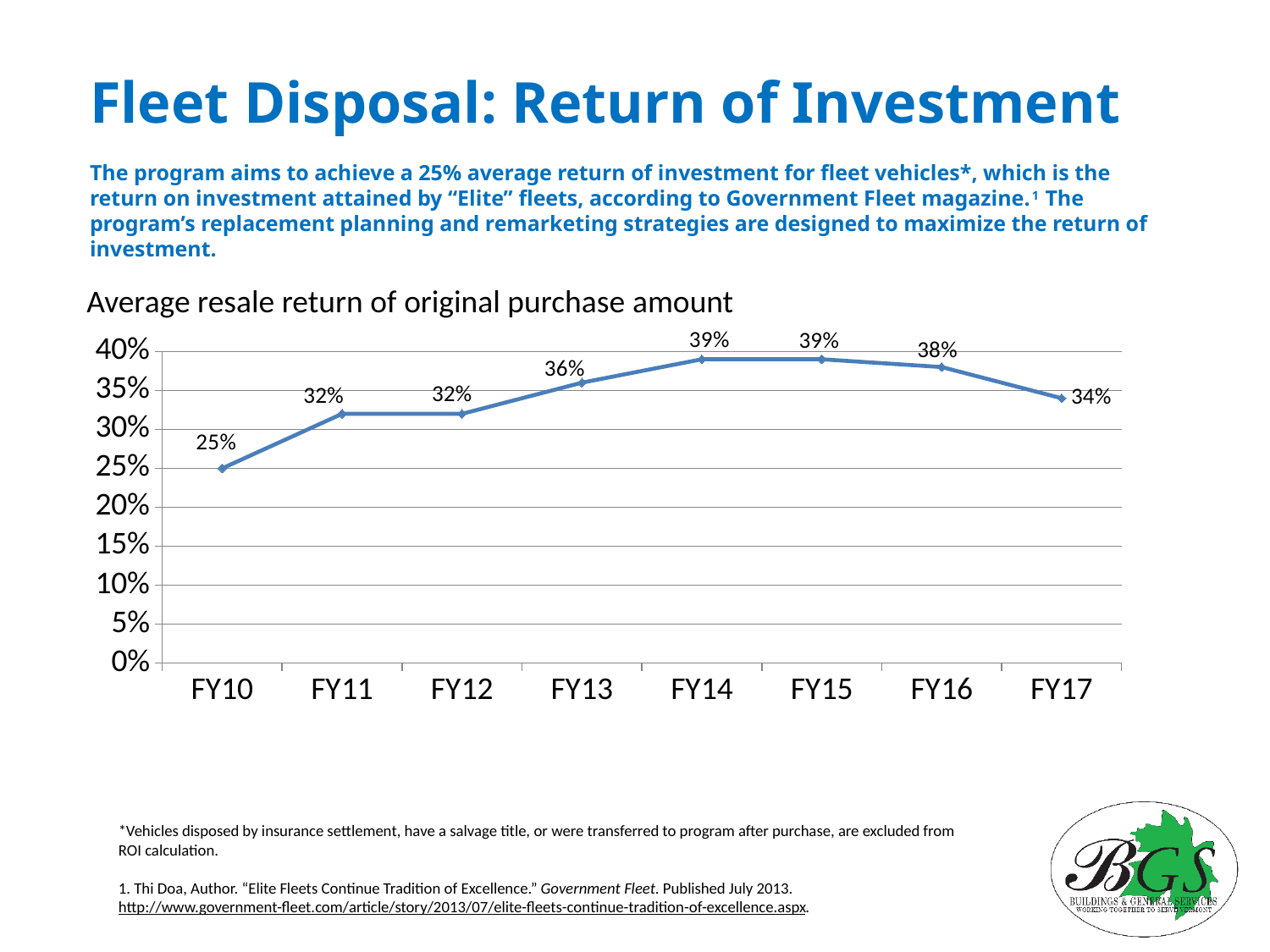
Is the value for FY11 greater or less than 30%? greater Which is larger, the average resale return for FY13 or for FY17? FY13 What kind of chart is shown on the slide? Line chart What is the average resale return for FY10? 25% Which fiscal year has the lowest average resale return? FY10 What is the title of the chart? Average resale return of original purchase amount What is the average resale return for FY13? 36% What is the difference between the average resale return in FY14 and FY10? 14% What is the difference between the average resale return in FY16 and FY17? 4% How many fiscal years are plotted on the chart? 8 Does the average resale return rise or fall from FY10 to FY14? Rise What is the average resale return for FY17? 34%